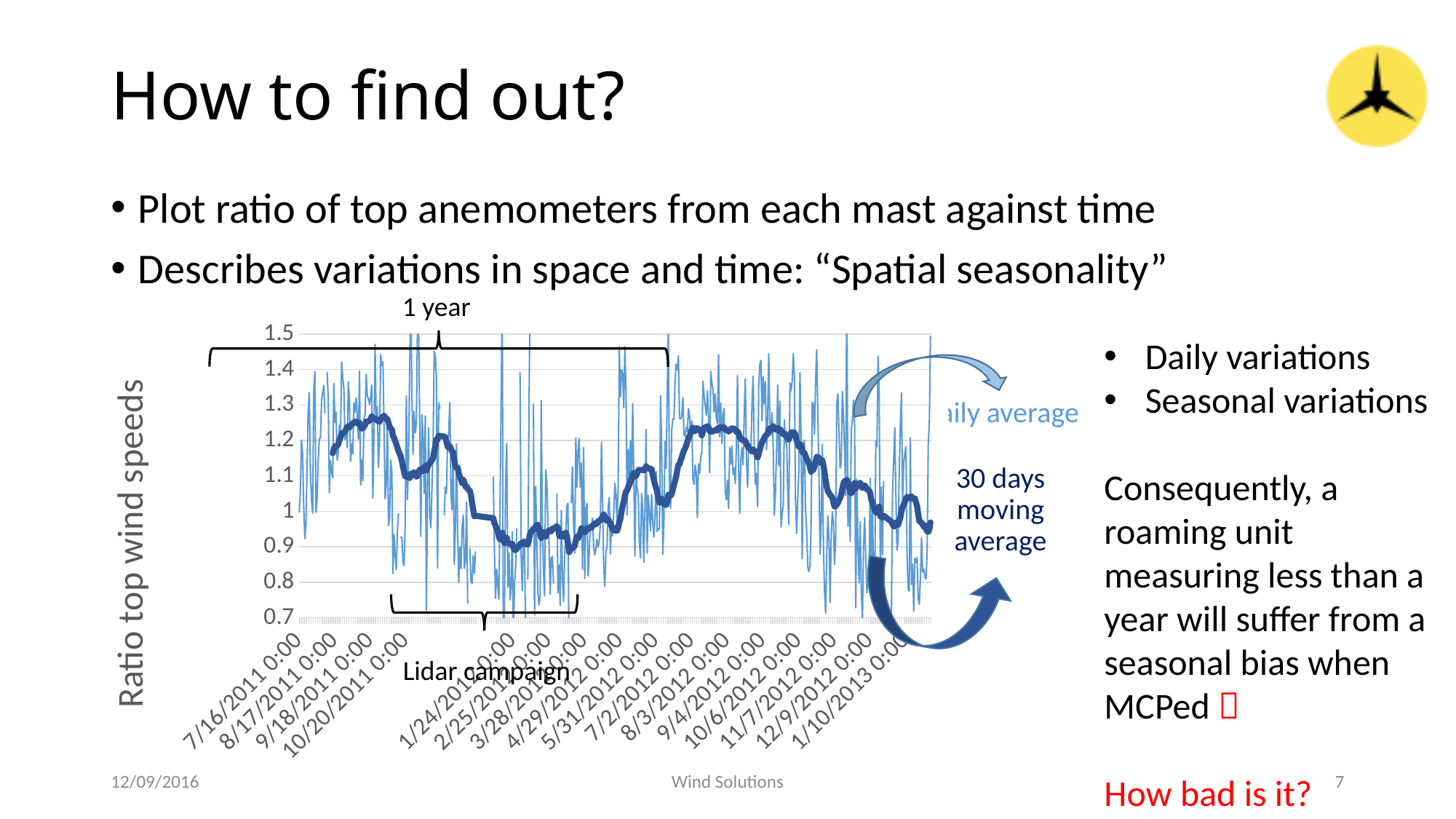
Is the 30 days moving average higher around 9/18/2011 or around 2/25/2012? 9/18/2011 How many series are plotted on the chart? 2 Which series is drawn with the thick dark blue line: the daily average or the 30 days moving average? 30 days moving average Does the 30 days moving average rise or fall between 9/18/2011 and 2/25/2012? fall What is the label of the vertical axis of the chart? Ratio top wind speeds What kind of chart is shown on the slide? line chart Is the 30 days moving average around 9/18/2011 greater or less than 1.2? greater Does the 30 days moving average rise or fall between 2/25/2012 and 8/3/2012? rise What is the highest value shown on the vertical axis of the chart? 1.5 Is the 30 days moving average around 1/10/2013 greater or less than 1.1? less Is the 30 days moving average around 8/3/2012 greater or less than 1.1? greater